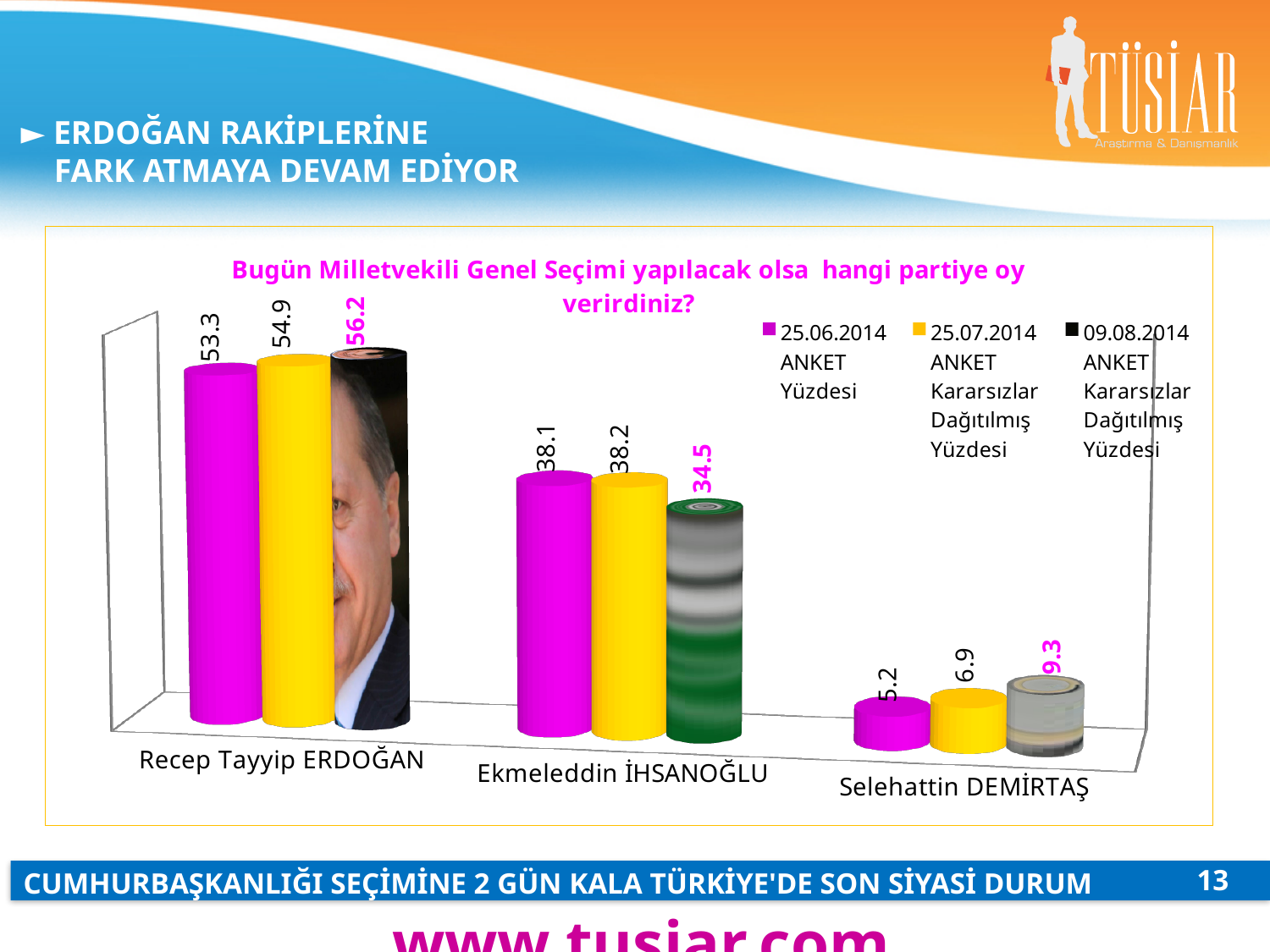
What kind of chart is shown on the slide? Bar chart What is the value for Selehattin DEMİRTAŞ in the 25.07.2014 ANKET Kararsızlar Dağıtılmış Yüzdesi series? 6.9 Which is larger for Ekmeleddin İHSANOĞLU: the 25.07.2014 value or the 09.08.2014 value? 25.07.2014 Do Recep Tayyip ERDOĞAN's values rise or fall across the three survey dates? Rise Which candidate has the lowest value in the 25.06.2014 ANKET Yüzdesi series? Selehattin DEMİRTAŞ What is the difference between Recep Tayyip ERDOĞAN's and Ekmeleddin İHSANOĞLU's values in the 09.08.2014 series? 21.7 How many series does the chart legend list? 3 What is the value for Recep Tayyip ERDOĞAN in the 09.08.2014 ANKET Kararsızlar Dağıtılmış Yüzdesi series? 56.2 How many candidates are shown on the x axis of the chart? 3 What is the value for Ekmeleddin İHSANOĞLU in the 25.06.2014 ANKET Yüzdesi series? 38.1 What is the difference between Selehattin DEMİRTAŞ's 09.08.2014 value and his 25.06.2014 value? 4.1 Which candidate has the highest value in the 09.08.2014 series? Recep Tayyip ERDOĞAN